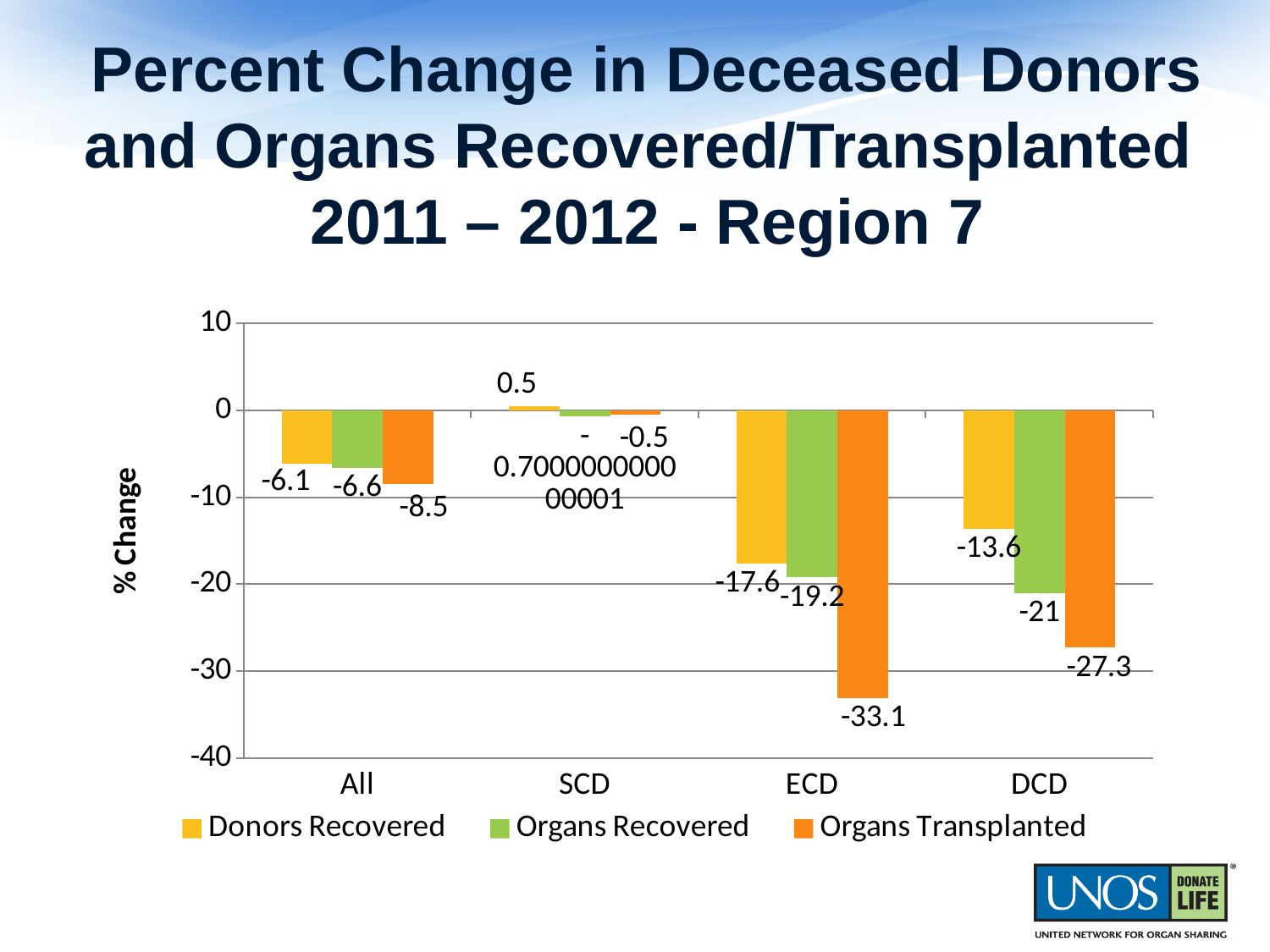
Which category has the lowest value for Organs Transplanted? ECD What is the difference between the Organs Transplanted values for ECD and DCD? 5.8 Which category has the highest value for Donors Recovered? SCD How many series does the legend list? 3 How many categories are shown on the x axis? 4 What kind of chart is shown on the slide? Bar chart What is the value for Organs Recovered in the DCD category? -21 What is the value for Donors Recovered in the SCD category? 0.5 What is the value for Donors Recovered in the All category? -6.1 Which is larger, the Donors Recovered value for ECD or for DCD? DCD What is the label of the y axis? % Change What is the value for Organs Transplanted in the ECD category? -33.1